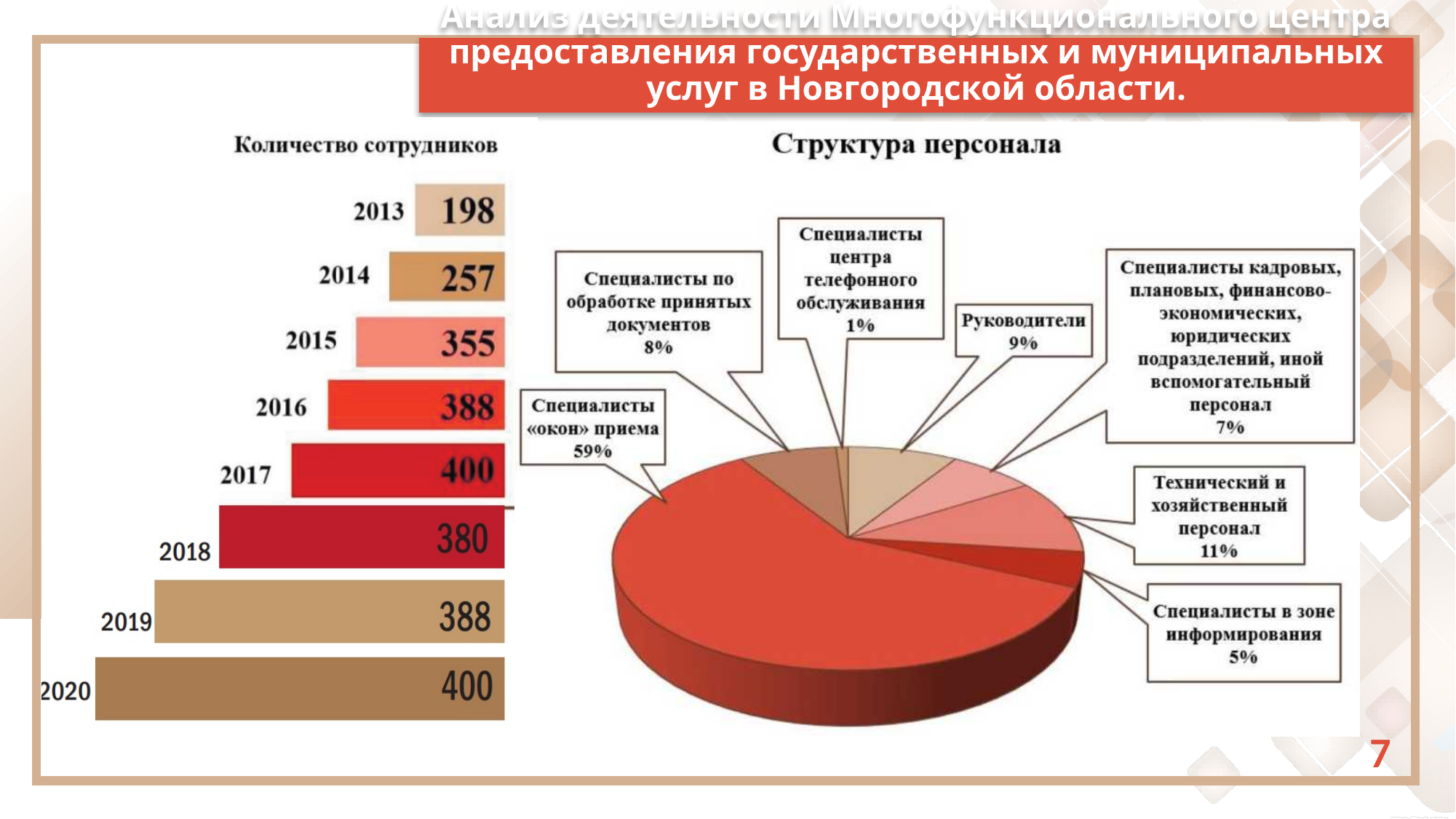
In the 'Количество сотрудников' chart, what is the difference between the values for 2015 and 2014? 98 What kind of chart is 'Количество сотрудников'? Bar chart In the 'Количество сотрудников' chart, do the values rise or fall from 2013 to 2017? Rise In the 'Структура персонала' chart, what is the share of 'Технический и хозяйственный персонал'? 11% In the 'Количество сотрудников' chart, what is the value for 2018? 380 In the 'Структура персонала' chart, which category has the smallest share? Специалисты центра телефонного обслуживания In the 'Количество сотрудников' chart, which is larger, the value for 2016 or the value for 2018? 2016 In the 'Количество сотрудников' chart, which year has the lowest number of employees? 2013 In the 'Количество сотрудников' chart, what is the value for 2013? 198 In the 'Количество сотрудников' chart, how many years are shown? 8 In the 'Структура персонала' chart, how many categories are shown? 7 In the 'Структура персонала' chart, what share do 'Специалисты «окон» приема' have? 59%